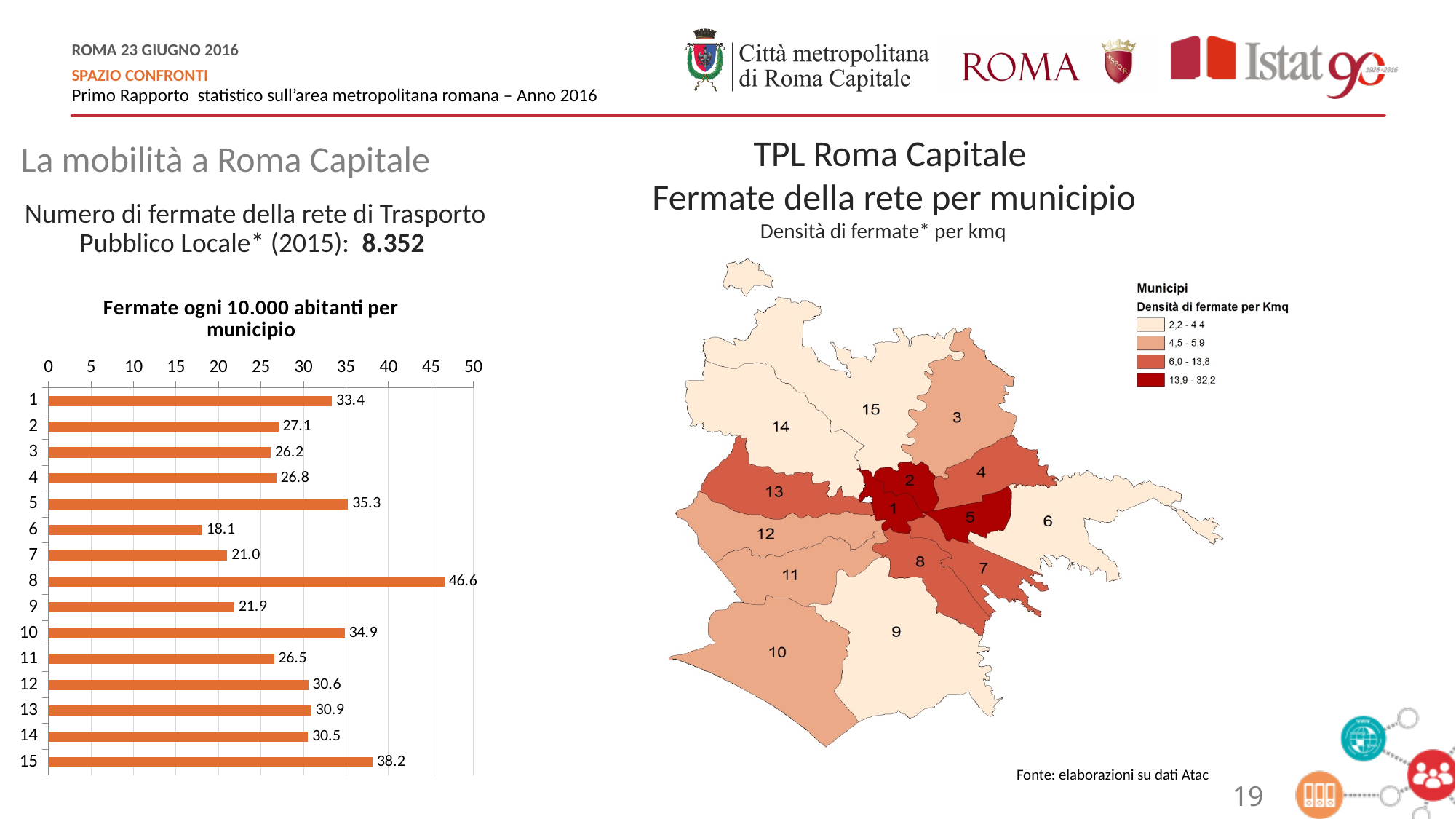
In the bar chart 'Fermate ogni 10.000 abitanti per municipio', which has a larger value, municipio 5 or municipio 10? municipio 5 In the bar chart 'Fermate ogni 10.000 abitanti per municipio', what is the value for municipio 12? 30.6 In the bar chart 'Fermate ogni 10.000 abitanti per municipio', what is the value for municipio 6? 18.1 What kind of chart is 'Fermate ogni 10.000 abitanti per municipio'? bar chart In the bar chart 'Fermate ogni 10.000 abitanti per municipio', is the value for municipio 8 greater or less than 45? greater In the bar chart 'Fermate ogni 10.000 abitanti per municipio', what is the difference between the values for municipio 15 and municipio 1? 4.8 In the bar chart 'Fermate ogni 10.000 abitanti per municipio', which municipio has the highest value? 8 In the bar chart 'Fermate ogni 10.000 abitanti per municipio', what is the value for municipio 8? 46.6 How many municipi are shown in the bar chart 'Fermate ogni 10.000 abitanti per municipio'? 15 In the bar chart 'Fermate ogni 10.000 abitanti per municipio', which municipio has the lowest value? 6 In the bar chart 'Fermate ogni 10.000 abitanti per municipio', what is the value for municipio 15? 38.2 In the bar chart 'Fermate ogni 10.000 abitanti per municipio', what is the difference between the values for municipio 8 and municipio 6? 28.5